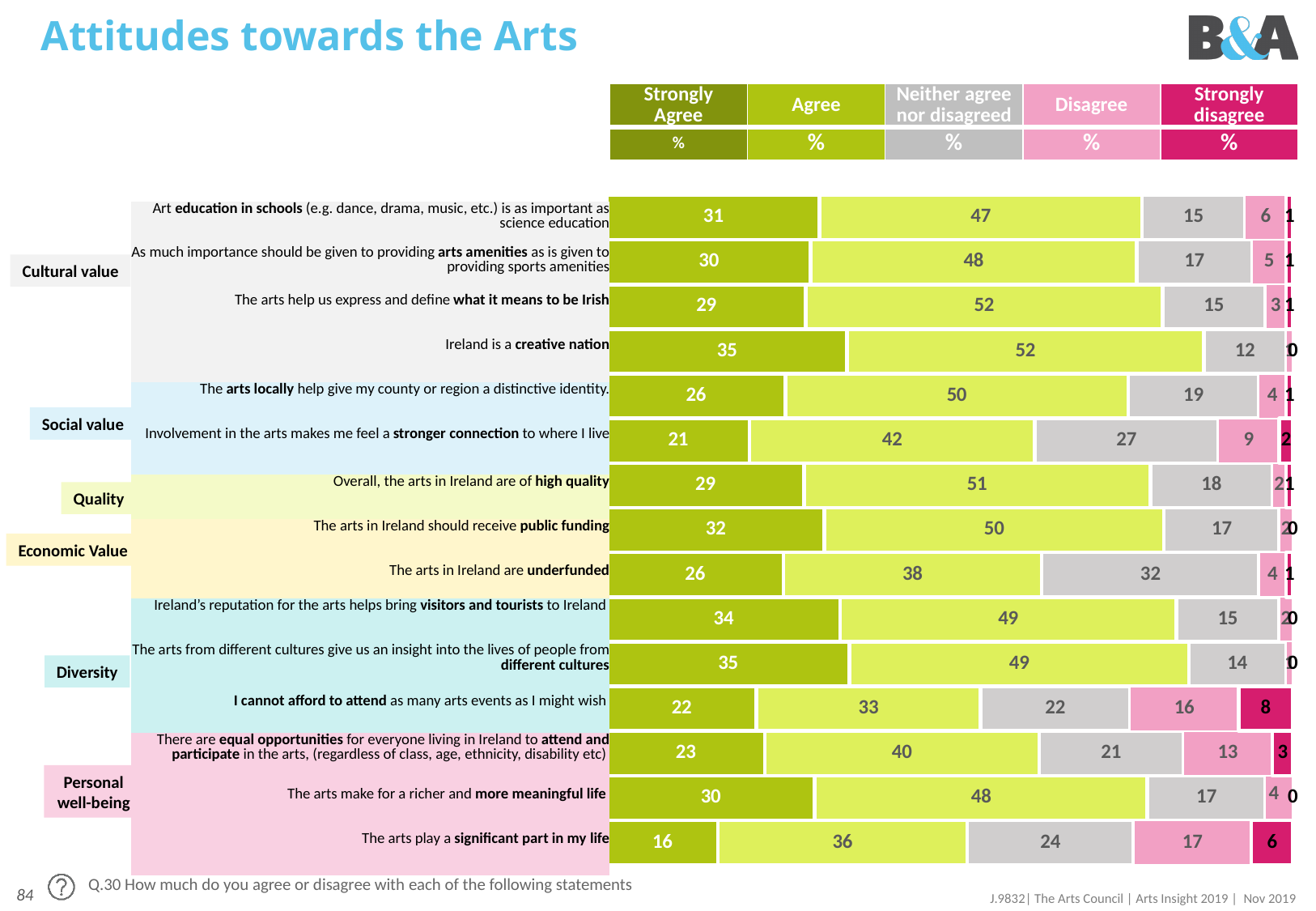
What percentage strongly agree that art education in schools is as important as science education? 31 What is the total of the stacked bar for 'There are equal opportunities for everyone living in Ireland to attend and participate in the arts'? 100 What percentage neither agree nor disagree that the arts in Ireland are underfunded? 32 What is the difference between the Agree percentage for 'Ireland is a creative nation' and the Agree percentage for 'The arts play a significant part in my life'? 16 How many statements are plotted in the chart? 15 Which statement has the highest Strongly disagree percentage? I cannot afford to attend as many arts events as I might wish How many response categories does the legend list? 5 What kind of chart is shown on the slide? Stacked bar chart Which has a higher Disagree percentage: 'The arts play a significant part in my life' or 'There are equal opportunities for everyone living in Ireland to attend and participate in the arts'? The arts play a significant part in my life Which statement has the lowest Strongly Agree percentage? The arts play a significant part in my life What percentage strongly disagree that they cannot afford to attend as many arts events as they might wish? 8 What percentage agree that the arts help us express and define what it means to be Irish? 52